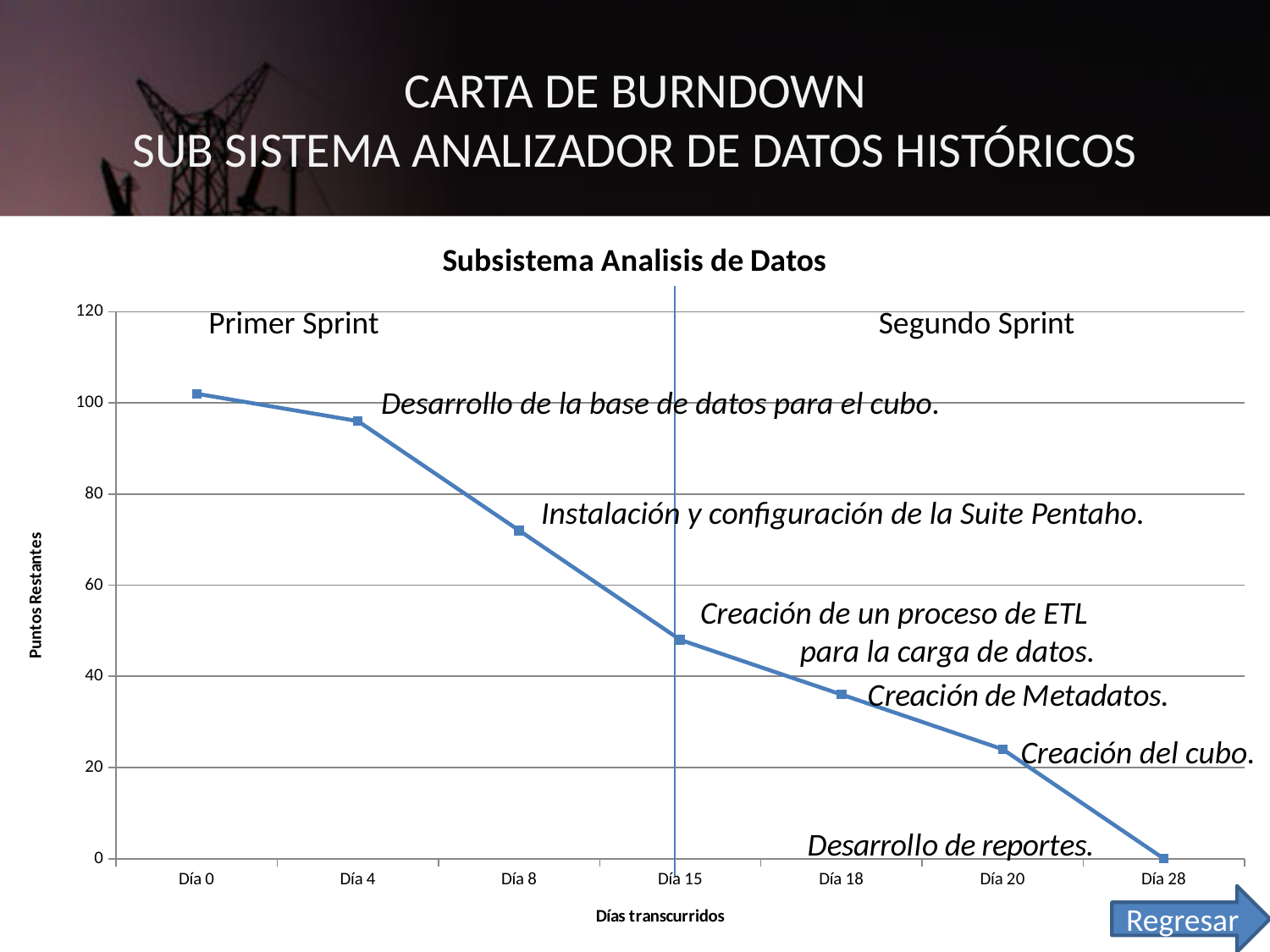
Do the values rise or fall as the days progress along the x axis? fall Which day has the lowest number of remaining points? Día 28 Which day has the highest number of remaining points? Día 0 How many data points are plotted on the line? 7 What is the label of the vertical axis? Puntos Restantes What kind of chart is shown on the slide? line chart What is the value of Puntos Restantes at Día 28? 0 What is the title of the chart? Subsistema Analisis de Datos Is the value for Día 18 greater or less than 40? less Is the value for Día 4 greater or less than 100? less Which has more remaining points, Día 8 or Día 18? Día 8 Is the value for Día 8 greater or less than 80? less